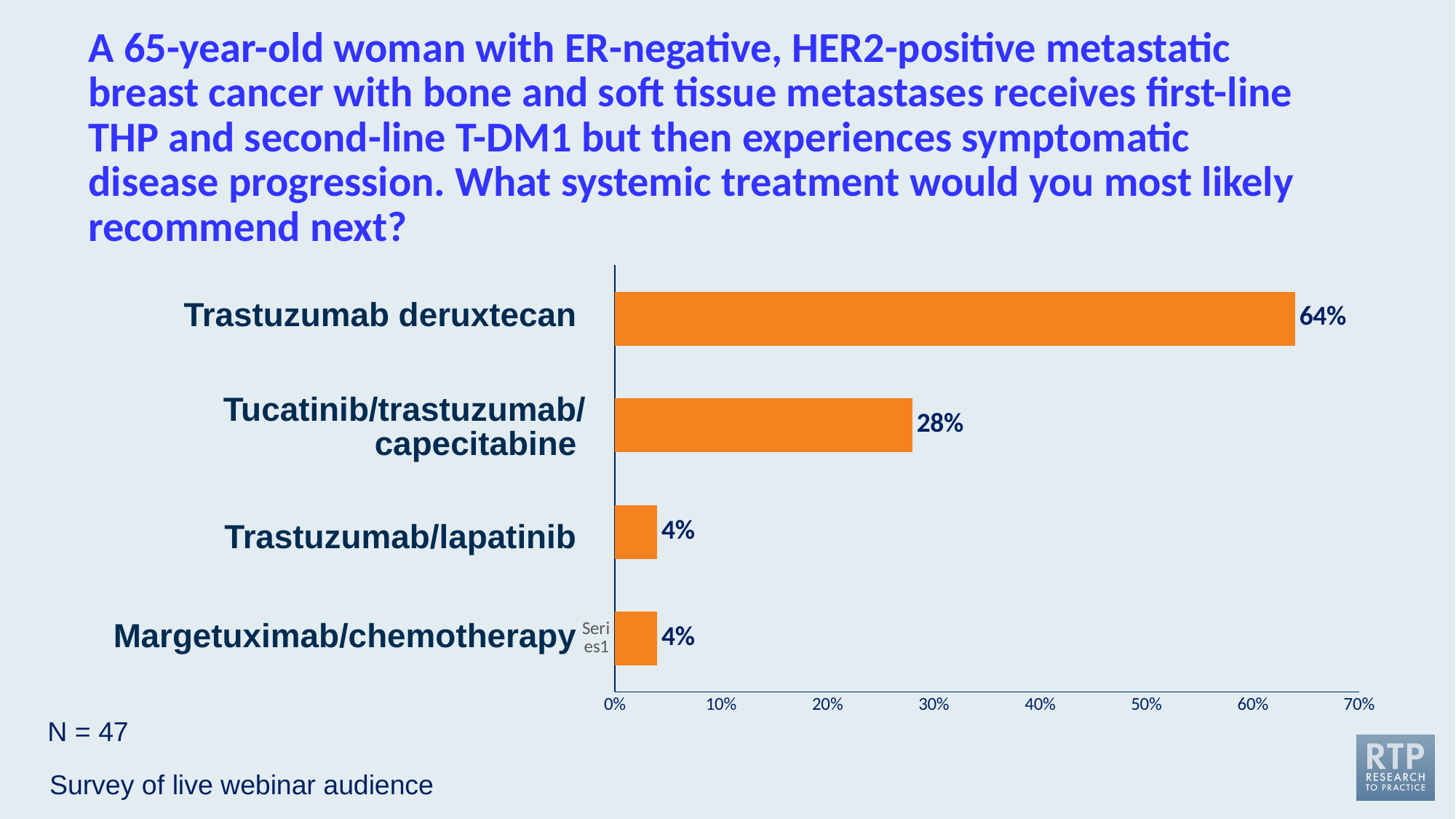
What is the maximum value shown on the horizontal axis? 70% How many treatment options are shown in the chart? 4 Which treatment option received the highest percentage of responses? Trastuzumab deruxtecan Which received a larger share of responses, Tucatinib/trastuzumab/capecitabine or Trastuzumab/lapatinib? Tucatinib/trastuzumab/capecitabine What is the value for Tucatinib/trastuzumab/capecitabine? 28% What percentage of respondents chose Trastuzumab deruxtecan? 64% What type of chart is shown on the slide? Bar chart What percentage of respondents chose Trastuzumab/lapatinib? 4% What is the value for Margetuximab/chemotherapy? 4% What is the difference in percentage points between Trastuzumab deruxtecan and Tucatinib/trastuzumab/capecitabine? 36 percentage points Is the value for Trastuzumab deruxtecan greater or less than 60%? greater What is the combined percentage for Trastuzumab/lapatinib and Margetuximab/chemotherapy? 8%